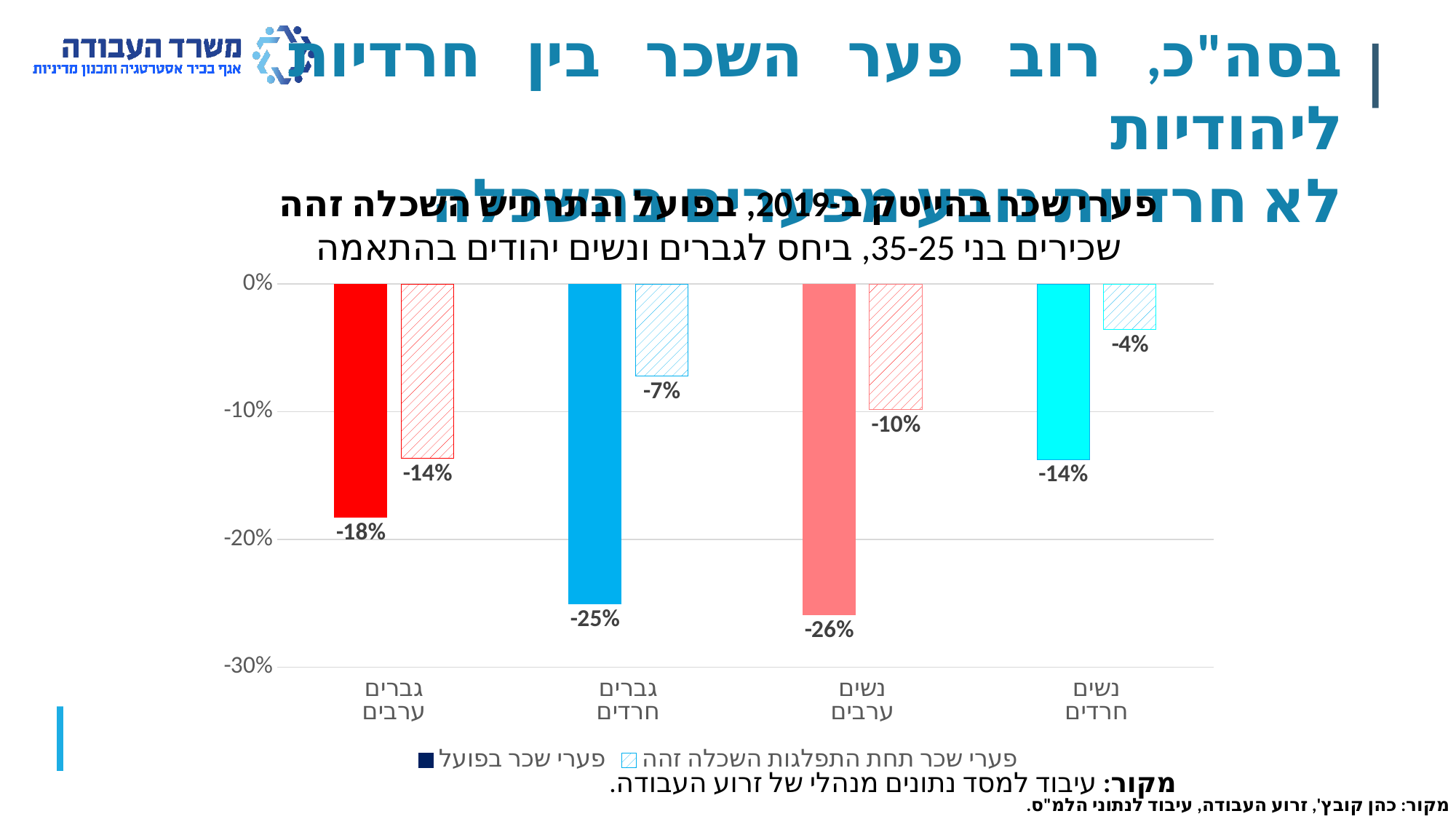
What is the actual wage gap (פערי שכר בפועל) for נשים ערבים? -26% Which category has the smallest wage gap under identical education distribution (פערי שכר תחת התפלגות השכלה זהה)? נשים חרדים What is the wage gap under identical education distribution for גברים ערבים? -14% Is the actual wage gap for גברים ערבים above or below -20% on the axis (i.e., less negative than -20%)? less negative than -20% How many series does the chart legend list? 2 What is the actual wage gap (פערי שכר בפועל) for גברים חרדים? -25% Which category has the largest (most negative) actual wage gap (פערי שכר בפועל)? נשים ערבים What is the wage gap under identical education distribution (פערי שכר תחת התפלגות השכלה זהה) for נשים חרדים? -4% Which is more negative: the actual wage gap for גברים ערבים or for נשים חרדים? גברים ערבים What kind of chart is shown on the slide? Bar chart What is the difference between the actual wage gap and the gap under identical education distribution for גברים חרדים? 18 percentage points How many categories are shown on the x axis of the chart? 4